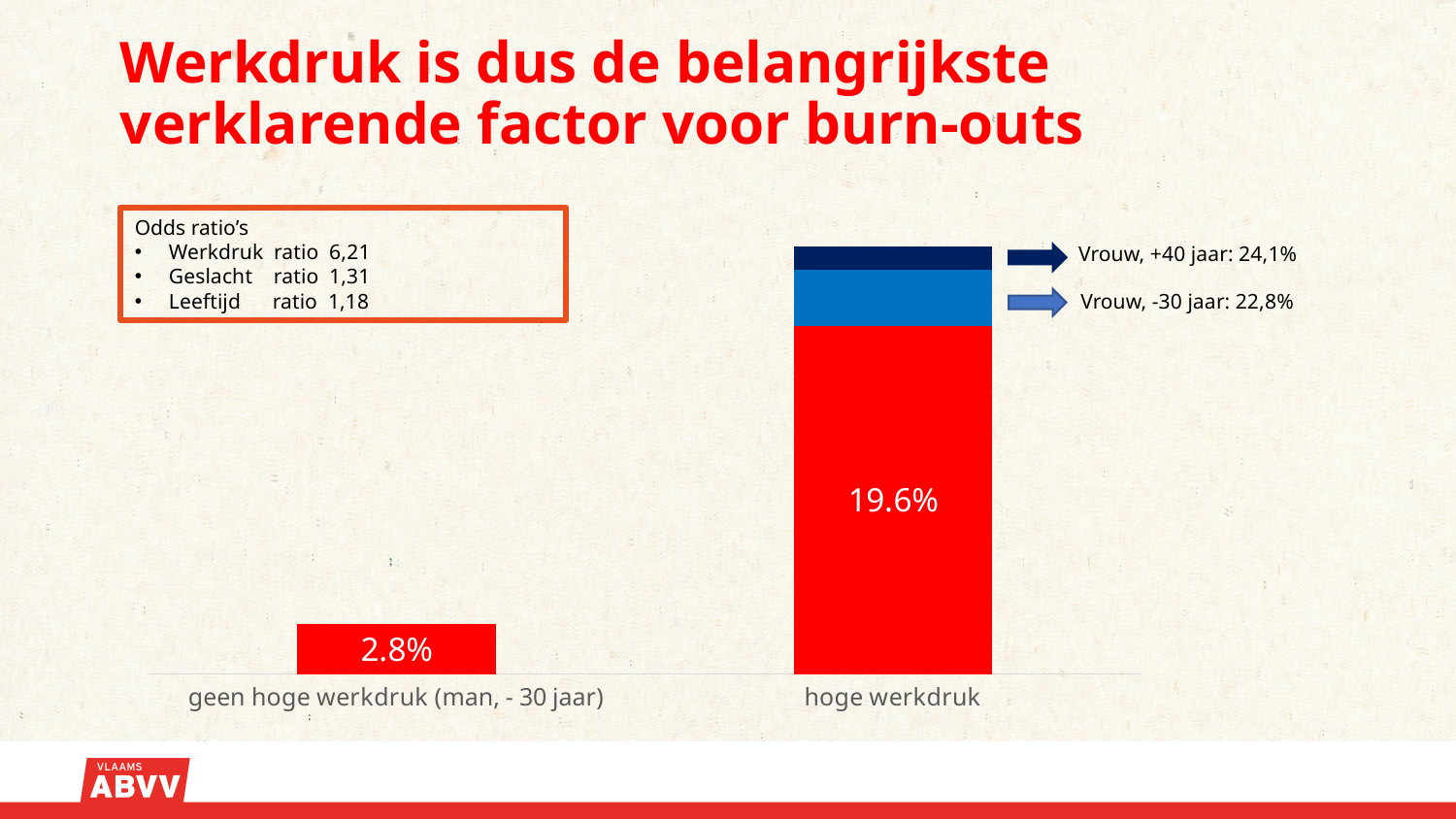
Which is larger: the value for 'hoge werkdruk' or for 'geen hoge werkdruk (man, - 30 jaar)'? hoge werkdruk How many blue segments are stacked on top of the red 'hoge werkdruk' bar? 2 Which category has the lowest value in the chart? geen hoge werkdruk (man, - 30 jaar) What is the difference between the 'hoge werkdruk' value (19.6%) and the 'geen hoge werkdruk (man, - 30 jaar)' value (2.8%)? 16.8% How many categories are shown on the x axis of the chart? 2 What is the value shown for 'geen hoge werkdruk (man, - 30 jaar)'? 2.8% What is the value shown for the 'hoge werkdruk' bar (red segment)? 19.6% What kind of chart is shown on the slide? bar chart What colour is the largest segment of the 'hoge werkdruk' bar? red What percentage is annotated next to the chart for 'Vrouw, +40 jaar'? 24,1% Which category has the highest value in the chart? hoge werkdruk What percentage is annotated next to the chart for 'Vrouw, -30 jaar'? 22,8%